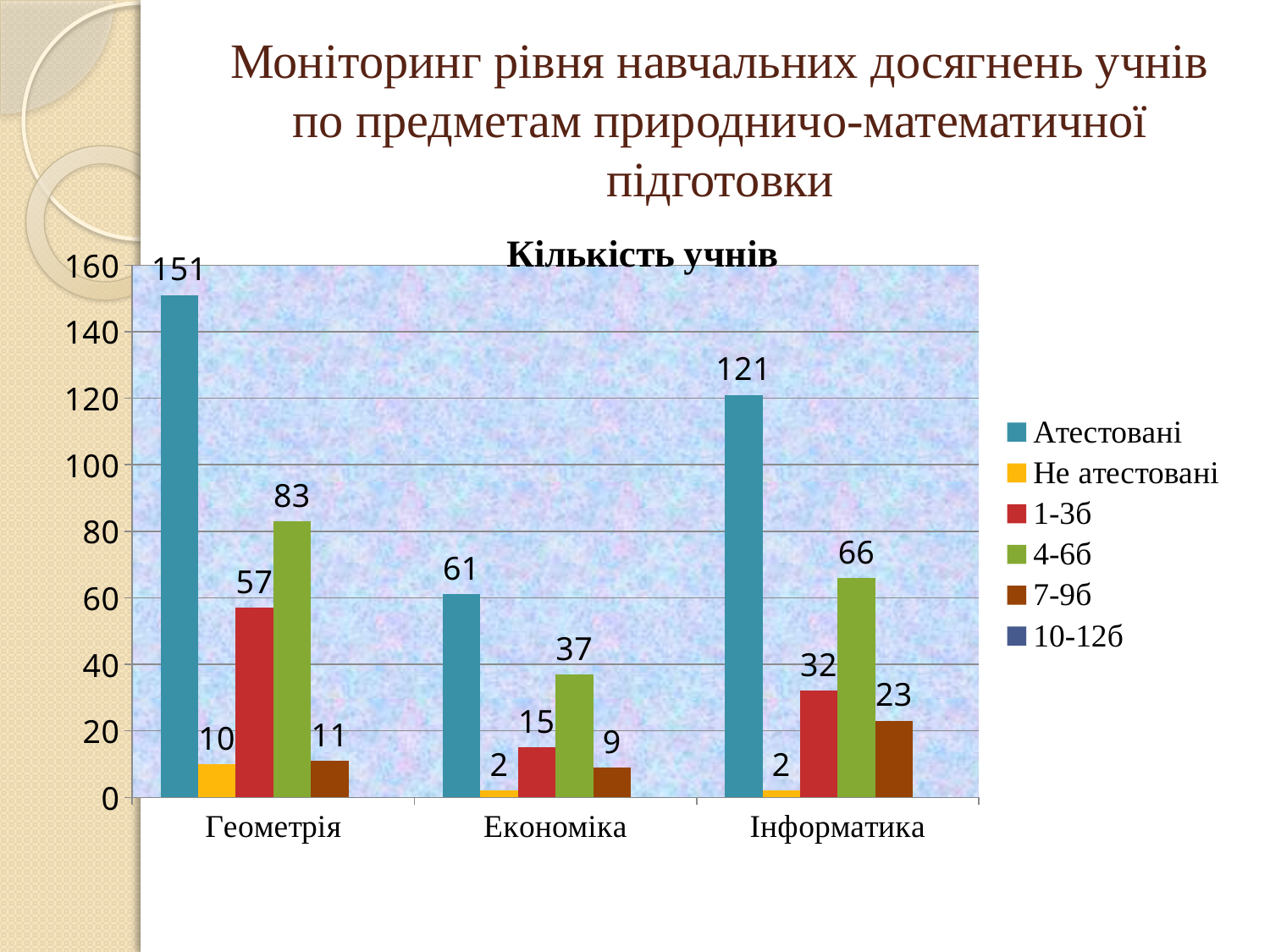
How many subject categories are shown on the x axis? 3 Which is larger: the 4-6б value for Геометрія or the 4-6б value for Інформатика? Геометрія What is the value of Не атестовані for Геометрія? 10 What is the value of Атестовані for Геометрія? 151 Which subject has the highest Атестовані value? Геометрія How many series does the legend list? 6 What type of chart is shown on the slide? bar chart What is the value of 4-6б for Інформатика? 66 What is the value of 1-3б for Економіка? 15 Which subject has the lowest 7-9б value? Економіка What is the chart's title? Кількість учнів What is the difference between the Атестовані values for Геометрія and Інформатика? 30